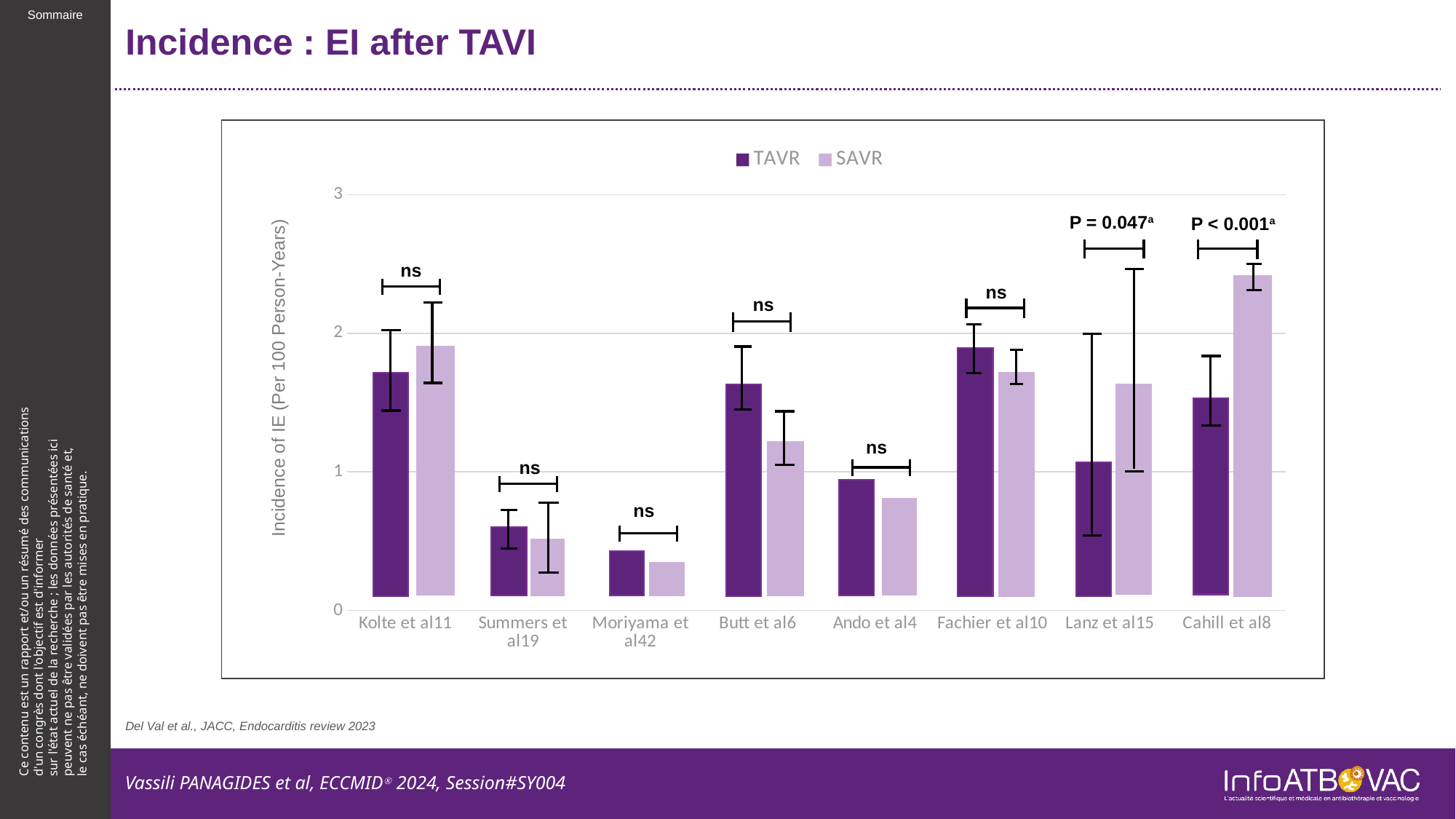
Which study has the lowest SAVR value? Moriyama et al42 Is the TAVR value for Ando et al4 greater or less than 1? less How many series does the legend list? 2 For Butt et al6, which is larger, the TAVR value or the SAVR value? TAVR What kind of chart is shown on the slide? bar chart Which study has the highest SAVR value? Cahill et al8 What P value is shown above the Cahill et al8 bars? P < 0.001 How many studies (categories) are shown on the x axis? 8 Which study has the lowest TAVR value? Moriyama et al42 Is the SAVR value for Butt et al6 greater or less than 1? greater For Cahill et al8, which is larger, the TAVR value or the SAVR value? SAVR Is the SAVR value for Cahill et al8 greater or less than 2? greater